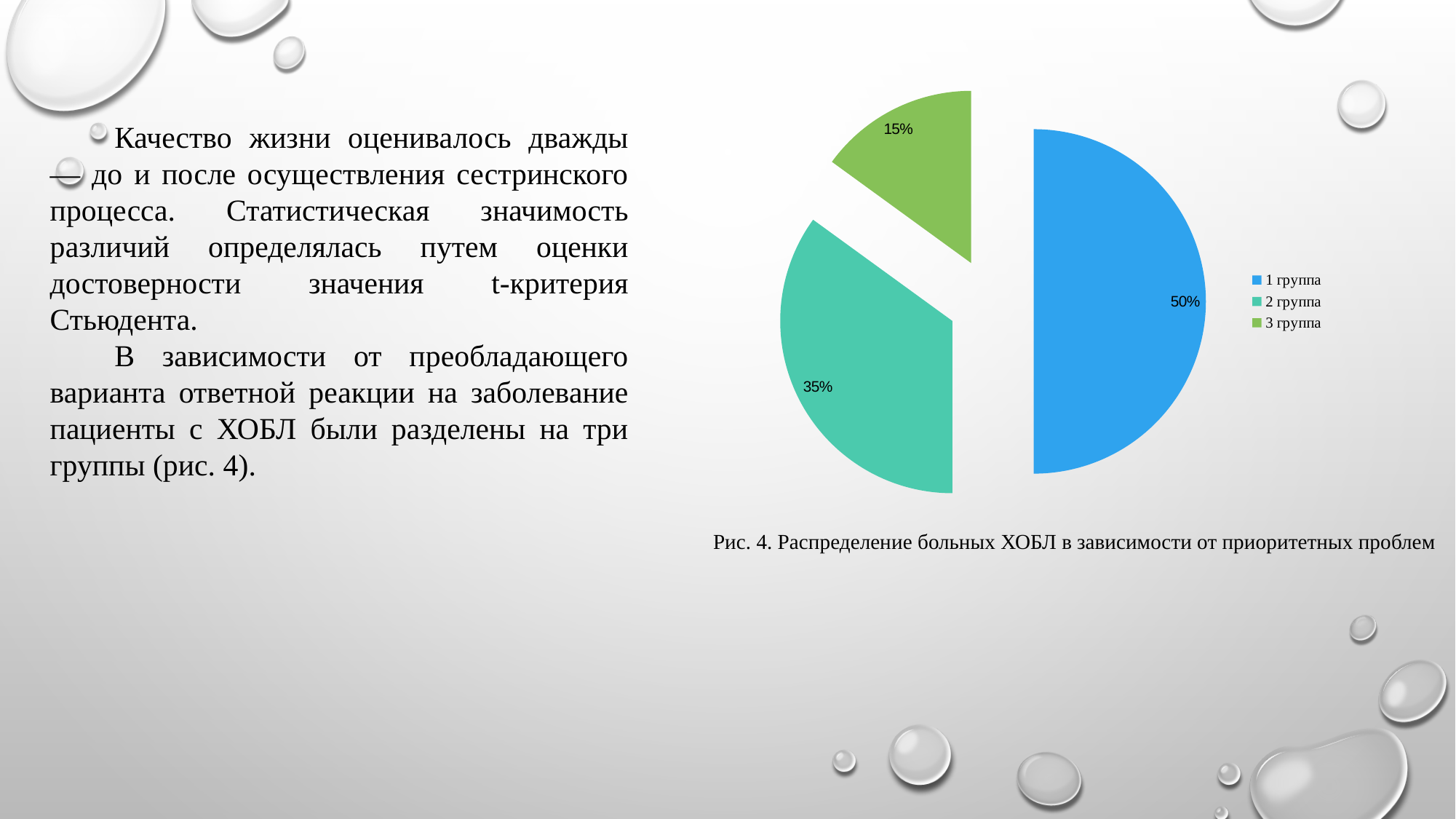
Which group has the smallest share of the pie chart? 3 группа What percentage of the pie chart does 2 группа account for? 35% How many entries does the legend list? 3 Which group has the largest share of the pie chart? 1 группа What is the difference in percentage points between 1 группа and 2 группа? 15 What is the difference in percentage points between 2 группа and 3 группа? 20 Which is larger, the share of 2 группа or the share of 3 группа? 2 группа How many slices does the pie chart have? 3 What colour is the slice for 1 группа? blue What percentage of the pie chart does 1 группа account for? 50% What percentage of the pie chart does 3 группа account for? 15% What kind of chart is shown on the slide? pie chart